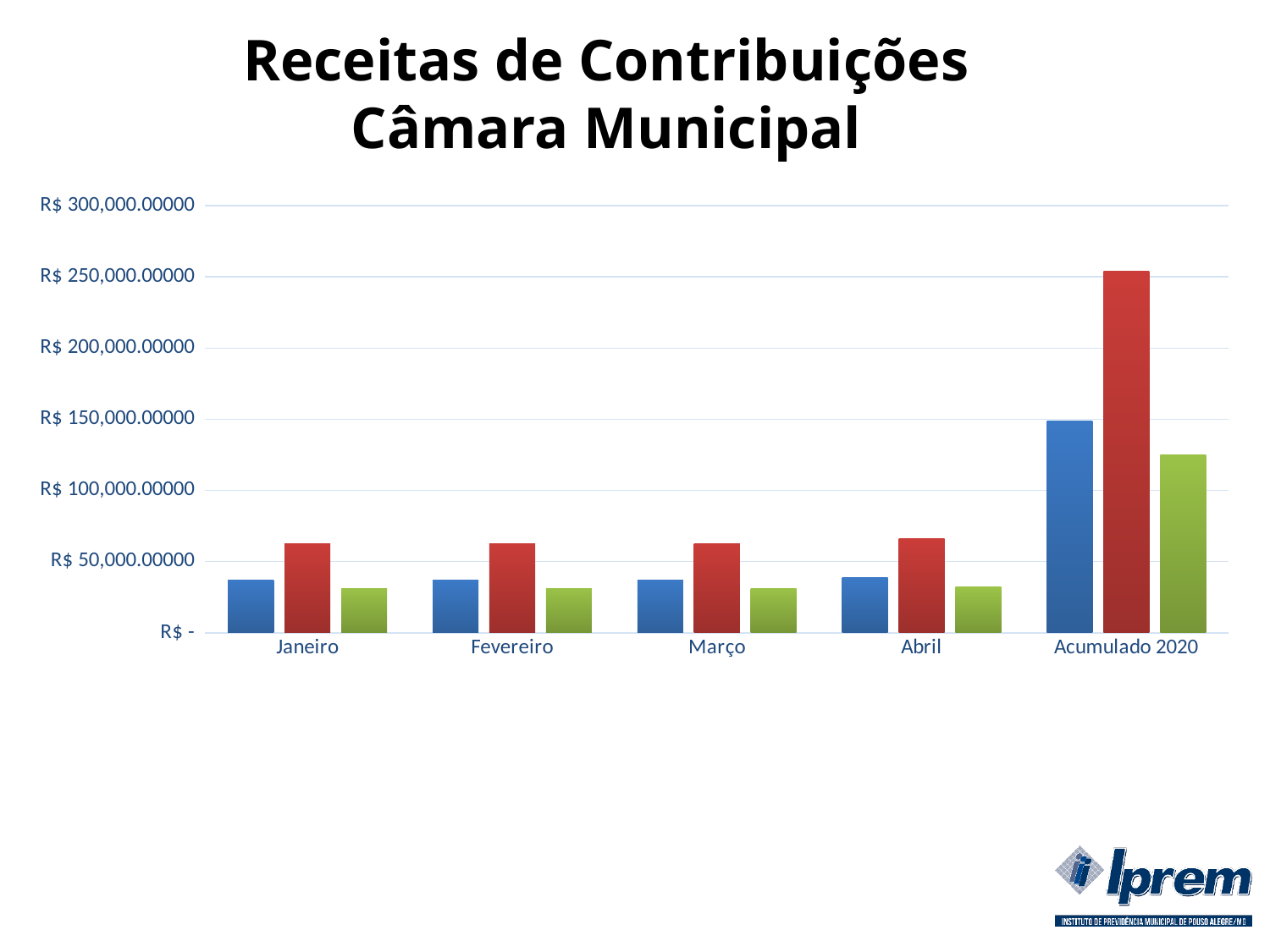
What kind of chart is shown on the slide? bar chart For Janeiro, which bar is larger, the blue bar or the green bar? the blue bar How many categories are shown on the x axis? 5 Is the value of the blue bar for Janeiro greater or less than R$ 50,000.00000? less What is the title of the chart? Receitas de Contribuições Câmara Municipal Is the value of the red bar for Acumulado 2020 greater or less than R$ 200,000.00000? greater Is the value of the green bar for Acumulado 2020 greater or less than R$ 100,000.00000? greater For Acumulado 2020, which bar is larger, the red bar or the blue bar? the red bar How many bars are plotted for each category? 3 Which category has the tallest bar in the chart? Acumulado 2020